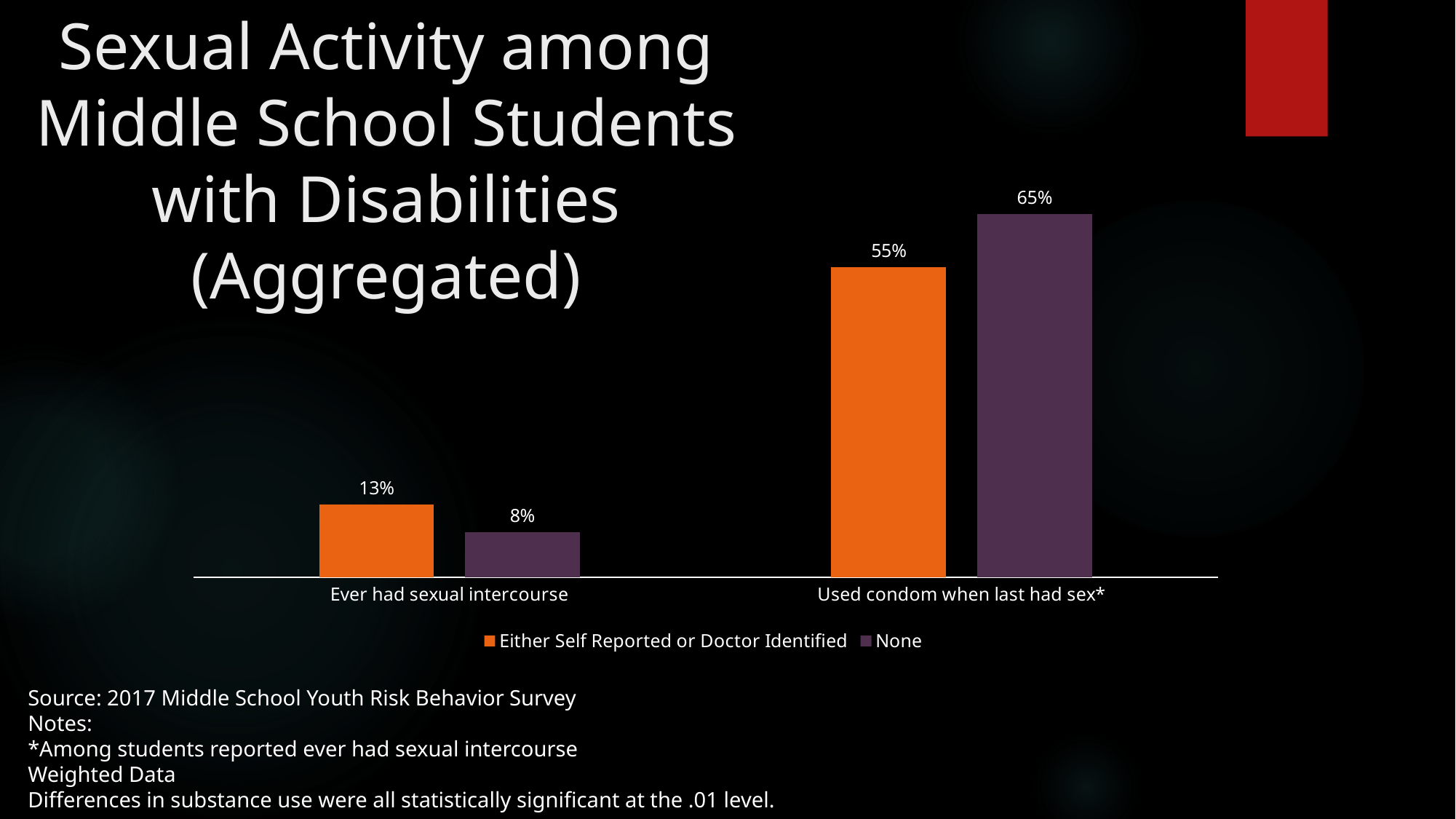
What percentage of students with no disability (None) used a condom when they last had sex? 65% For Used condom when last had sex*, which group has the larger value: Either Self Reported or Doctor Identified, or None? None How many categories are shown on the x axis of the chart? 2 What kind of chart is shown on the slide? Bar chart What percentage of students with no disability (None) ever had sexual intercourse? 8% What is the difference between the Either Self Reported or Doctor Identified and None values for Ever had sexual intercourse? 5% Which bar has the highest value on the chart? None, Used condom when last had sex* What is the difference between the None and Either Self Reported or Doctor Identified values for Used condom when last had sex*? 10% How many series does the legend list? 2 What percentage of students with a disability (Either Self Reported or Doctor Identified) used a condom when they last had sex? 55% What percentage of students with a disability (Either Self Reported or Doctor Identified) ever had sexual intercourse? 13% Which bar has the lowest value on the chart? None, Ever had sexual intercourse